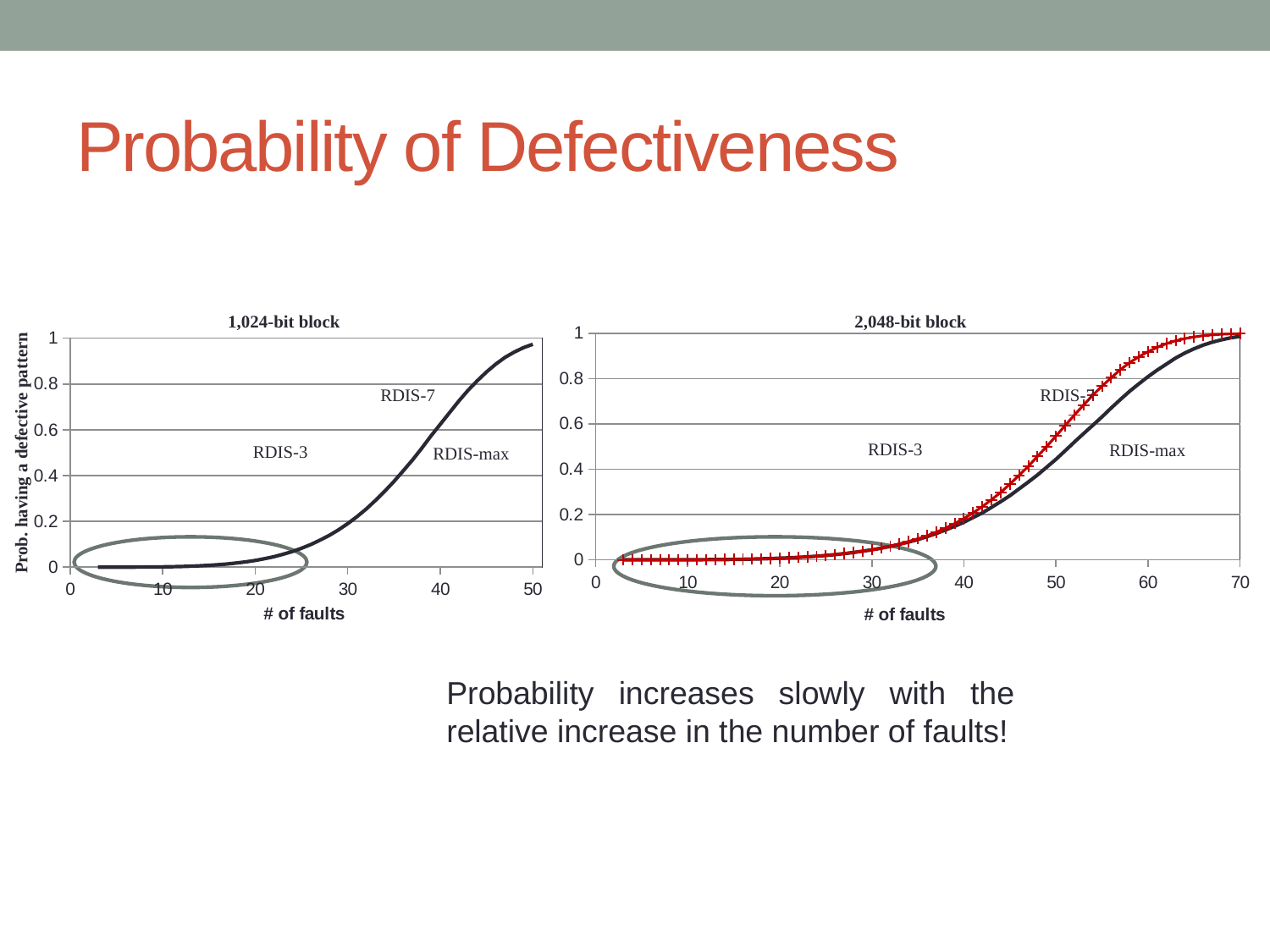
In the "2,048-bit block" chart, do the curves rise or fall along the x axis? rise In the "2,048-bit block" chart, is the value of the black curve at 30 faults greater or less than 0.2? less What is the y-axis label of the "1,024-bit block" chart? Prob. having a defective pattern In the "1,024-bit block" chart, is the value at 30 faults greater or less than 0.4? less What kind of chart is the one titled "1,024-bit block"? line chart In the "1,024-bit block" chart, is the value at 50 faults greater or less than 0.8? greater What is the x-axis label of the "2,048-bit block" chart? # of faults In the "1,024-bit block" chart, does the probability rise or fall as the number of faults increases? rise What is the highest tick value on the x axis of the "2,048-bit block" chart? 70